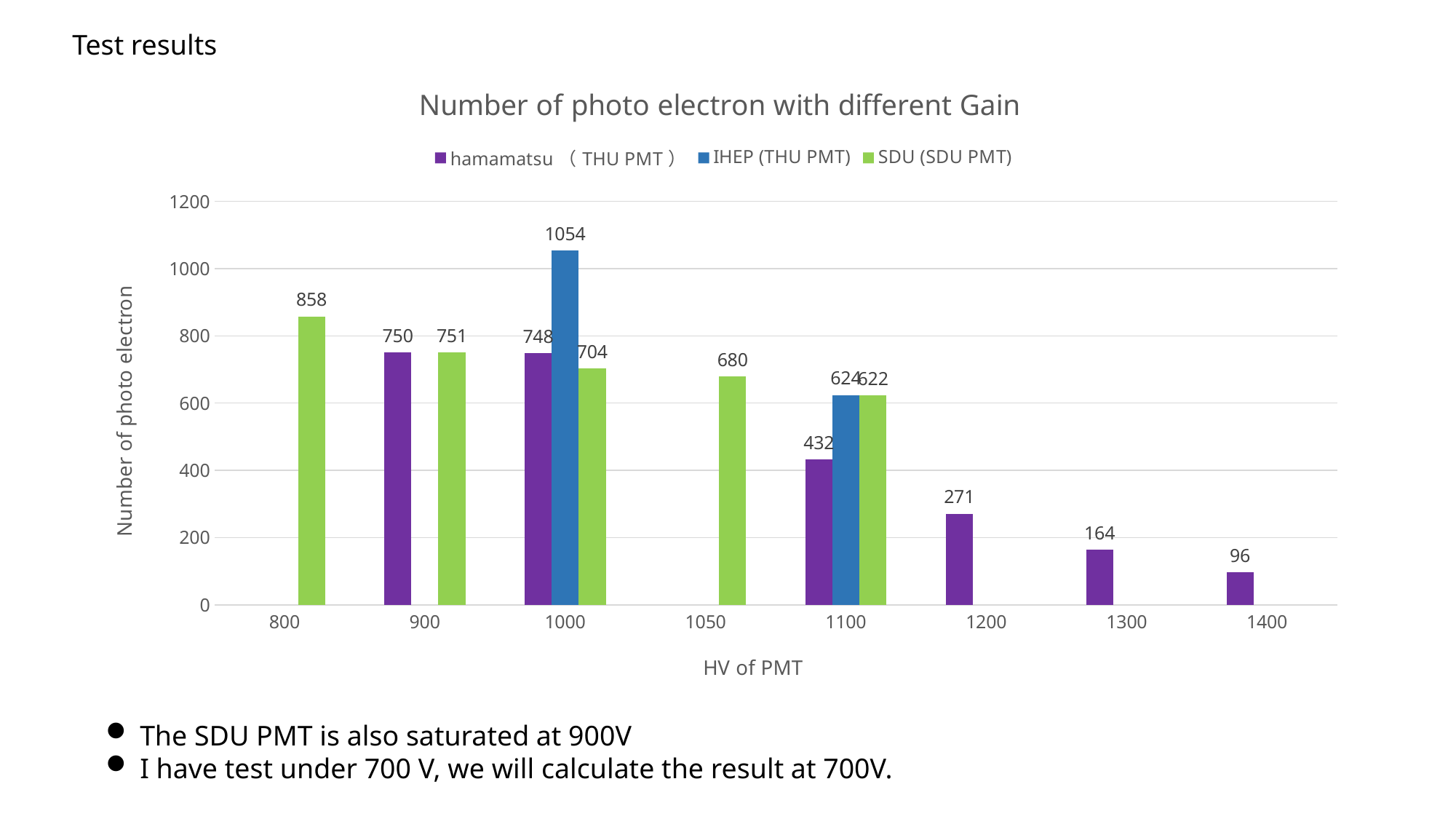
How many HV categories are shown on the x axis? 8 What kind of chart is shown? Bar chart How many series does the legend list? 3 At which HV does the IHEP (THU PMT) series reach its highest value? 1000 What is the difference between the IHEP (THU PMT) value and the hamamatsu (THU PMT) value at HV 1000? 306 What is the value for hamamatsu (THU PMT) at HV 1400? 96 What is the value for IHEP (THU PMT) at HV 1000? 1054 What is the value for SDU (SDU PMT) at HV 1050? 680 Which is larger at HV 1100: the hamamatsu (THU PMT) value or the SDU (SDU PMT) value? SDU (SDU PMT) Does the hamamatsu (THU PMT) series rise or fall from HV 1100 to HV 1400? Fall At which HV is the hamamatsu (THU PMT) value lowest? 1400 What is the value for SDU (SDU PMT) at HV 800? 858